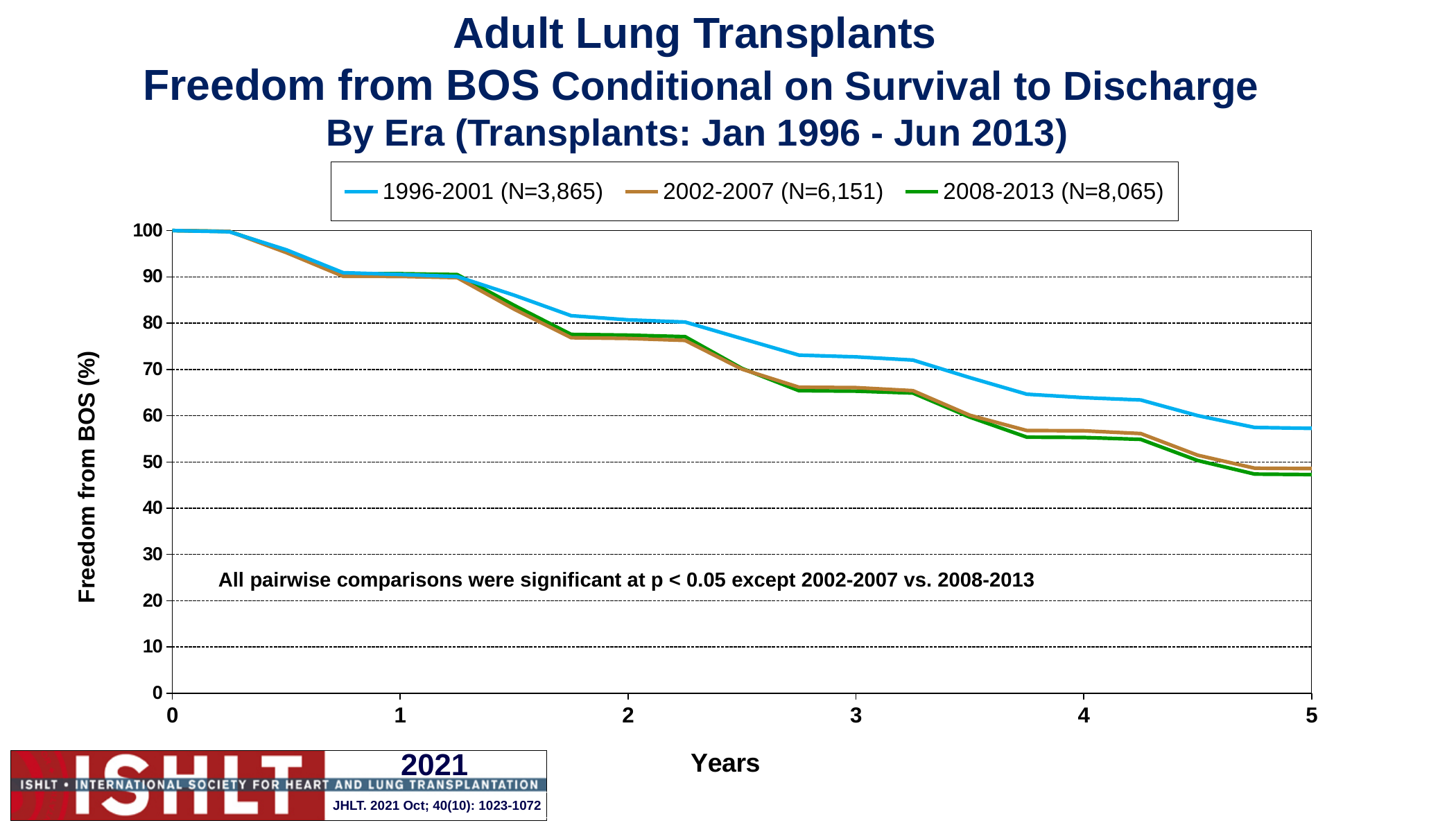
What is the freedom from BOS value for all three eras at year 0? 100 Which era has the highest freedom from BOS at year 5? 1996-2001 Is the value for 2008-2013 at year 4 greater or less than 60? less Is the value for 2008-2013 at year 5 greater or less than 50? less How many series does the legend list? 3 Is the value for 2002-2007 at year 3 greater or less than 70? less Do the freedom from BOS values rise or fall as years increase? fall What is the N shown in the legend for the 2002-2007 era? N=6,151 What kind of chart is shown on the slide? line chart At year 4, which is larger: the value for 1996-2001 or the value for 2008-2013? 1996-2001